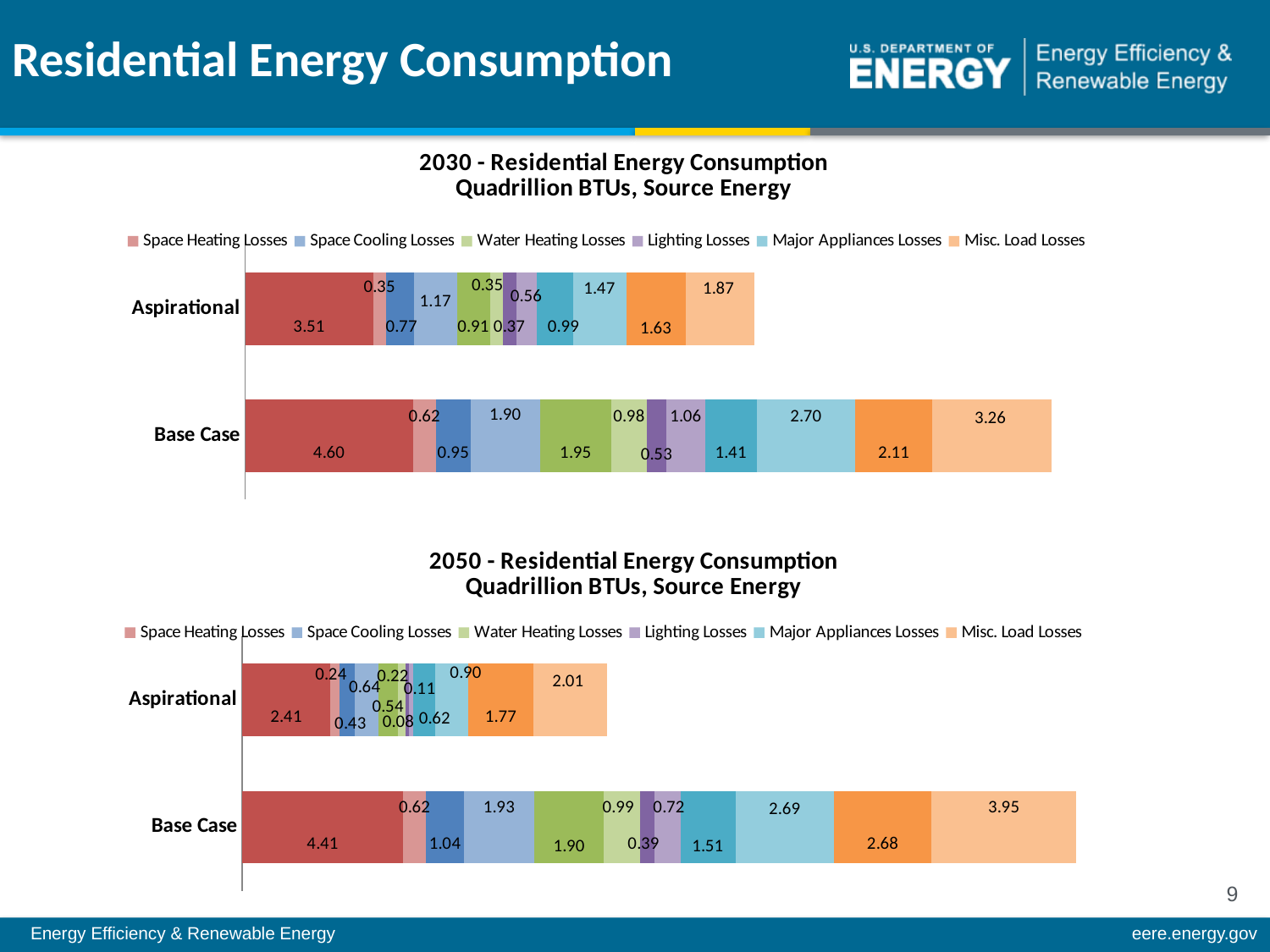
In the 2050 Residential Energy Consumption chart, what is the Misc. Load Losses value for Aspirational? 2.01 How many categories (bars) are shown in the 2030 Residential Energy Consumption chart? 2 In the 2050 Residential Energy Consumption chart, what is the largest labeled segment value in the Base Case bar? 4.41 In the 2030 Residential Energy Consumption chart, which scenario has the longer total bar? Base Case What is the title of the top chart on the slide? 2030 - Residential Energy Consumption Quadrillion BTUs, Source Energy In the 2030 Residential Energy Consumption chart, which scenario has the larger Space Cooling Losses value, Base Case or Aspirational? Base Case In the 2050 Residential Energy Consumption chart, what is the Space Heating Losses value for Base Case? 0.62 In the 2030 Residential Energy Consumption chart, what is the Misc. Load Losses value for Base Case? 3.26 In the 2050 Residential Energy Consumption chart, what is the difference between the Misc. Load Losses values for Base Case and Aspirational? 1.94 How many series does the legend of the 2050 Residential Energy Consumption chart list? 6 What kind of chart is used for the 2030 Residential Energy Consumption chart? Stacked bar chart In the 2030 Residential Energy Consumption chart, what is the Major Appliances Losses value for Base Case? 2.70